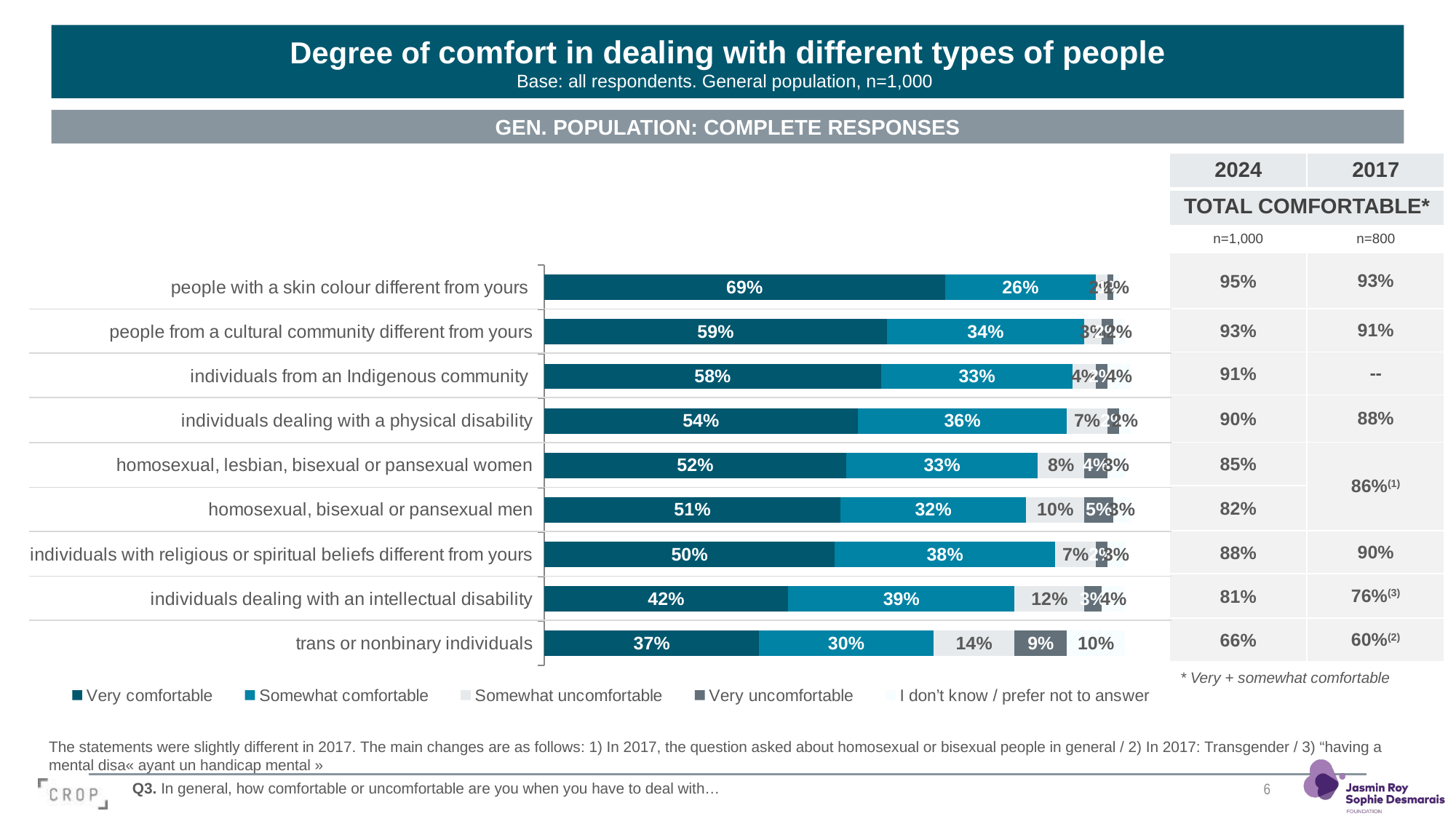
What is the difference between the 'Very comfortable' values for people with a skin colour different from yours and trans or nonbinary individuals? 32 percentage points Which has the larger 'Somewhat comfortable' value: individuals with religious or spiritual beliefs different from yours, or individuals dealing with a physical disability? individuals with religious or spiritual beliefs different from yours How many series does the chart legend list? 5 What is the 'Very comfortable' value for trans or nonbinary individuals? 37% What is the 'Somewhat comfortable' value for individuals dealing with an intellectual disability? 39% Do the 'Very comfortable' values rise or fall going from the top category to the bottom category? fall Which category has the highest 'Very comfortable' value? people with a skin colour different from yours Which category has the lowest 'Very comfortable' value? trans or nonbinary individuals How many categories (types of people) are plotted in the chart? 9 What is the 'Somewhat uncomfortable' value for trans or nonbinary individuals? 14% What is the first entry in the chart legend? Very comfortable What kind of chart is shown on the slide? bar chart